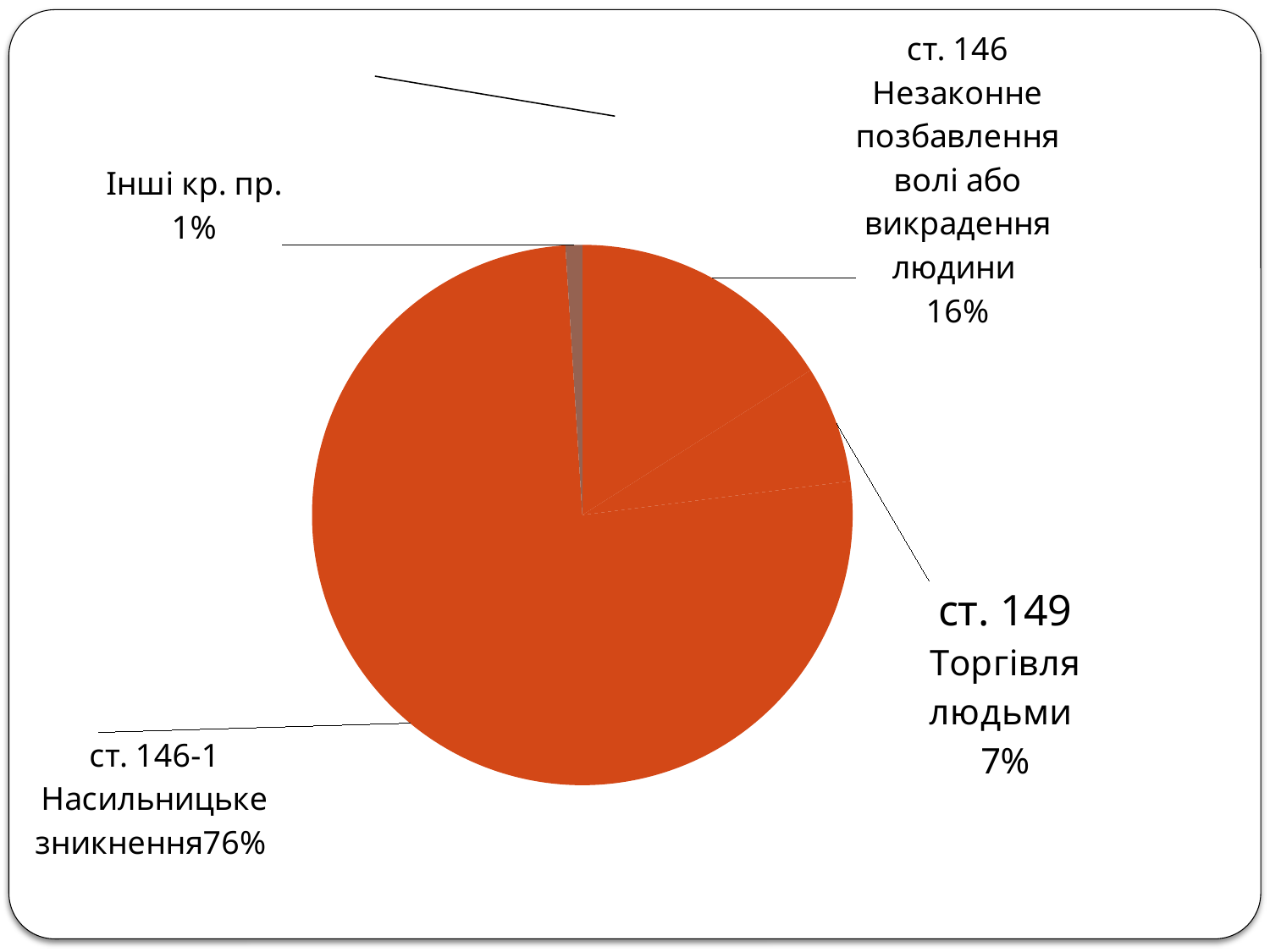
What is the difference in percentage points between the ст. 149 slice and the Інші кр. пр. slice? 6 Which is larger: the share for ст. 146 or the share for ст. 149? ст. 146 Which slice of the pie chart is the smallest? Інші кр. пр. Which slice of the pie chart is the largest? ст. 146-1 Насильницьке зникнення What share of the pie is labelled "ст. 146-1 Насильницьке зникнення"? 76% How many slices does the pie chart have? 4 What share of the pie is labelled "ст. 149 Торгівля людьми"? 7% What share of the pie is labelled "ст. 146 Незаконне позбавлення волі або викрадення людини"? 16% What kind of chart is shown on the slide? pie chart Which slice of the pie chart is shown in a different (brownish) colour from the others? Інші кр. пр. What is the difference in percentage points between the ст. 146-1 slice and the ст. 146 slice? 60